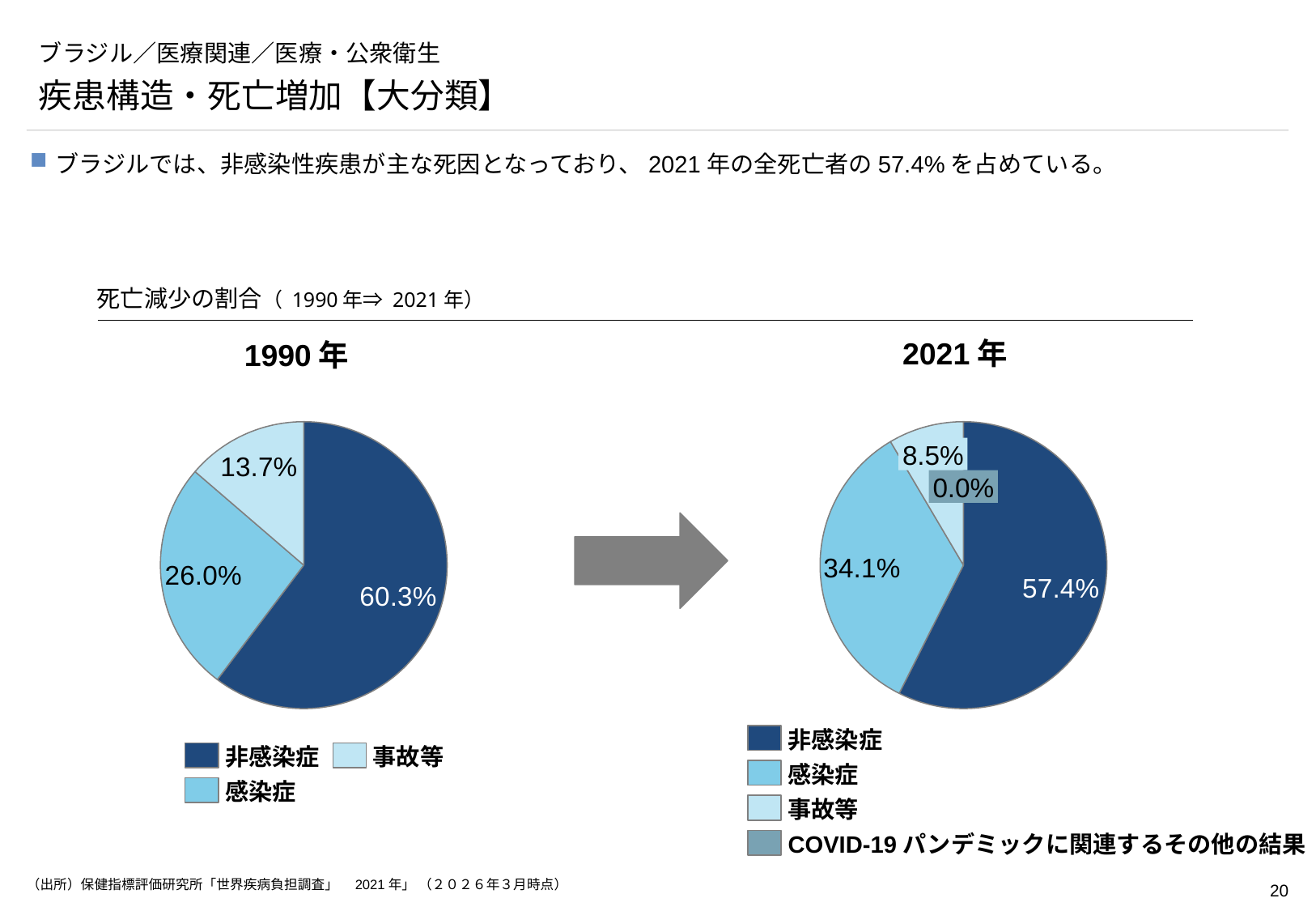
In the 2021年 pie chart, which category has the largest share? 非感染症 In the 2021年 pie chart, what share is shown for 感染症? 34.1% In the 2021年 pie chart, what share is shown for 非感染症? 57.4% Which is larger: the 事故等 share in the 1990年 chart or the 事故等 share in the 2021年 chart? 1990年 What type of chart is used for the 1990年 and 2021年 data? Pie chart What is the difference between the 感染症 share in the 2021年 chart and the 感染症 share in the 1990年 chart? 8.1% In the 1990年 pie chart, what share is shown for 事故等? 13.7% In the 1990年 pie chart, what share is shown for 感染症? 26.0% In the 2021年 pie chart, what share is shown for COVID-19 パンデミックに関連するその他の結果? 0.0% How many categories does the legend of the 2021年 pie chart list? 4 In the 1990年 pie chart, what share is shown for 非感染症? 60.3% In the 1990年 pie chart, which category has the smallest share? 事故等